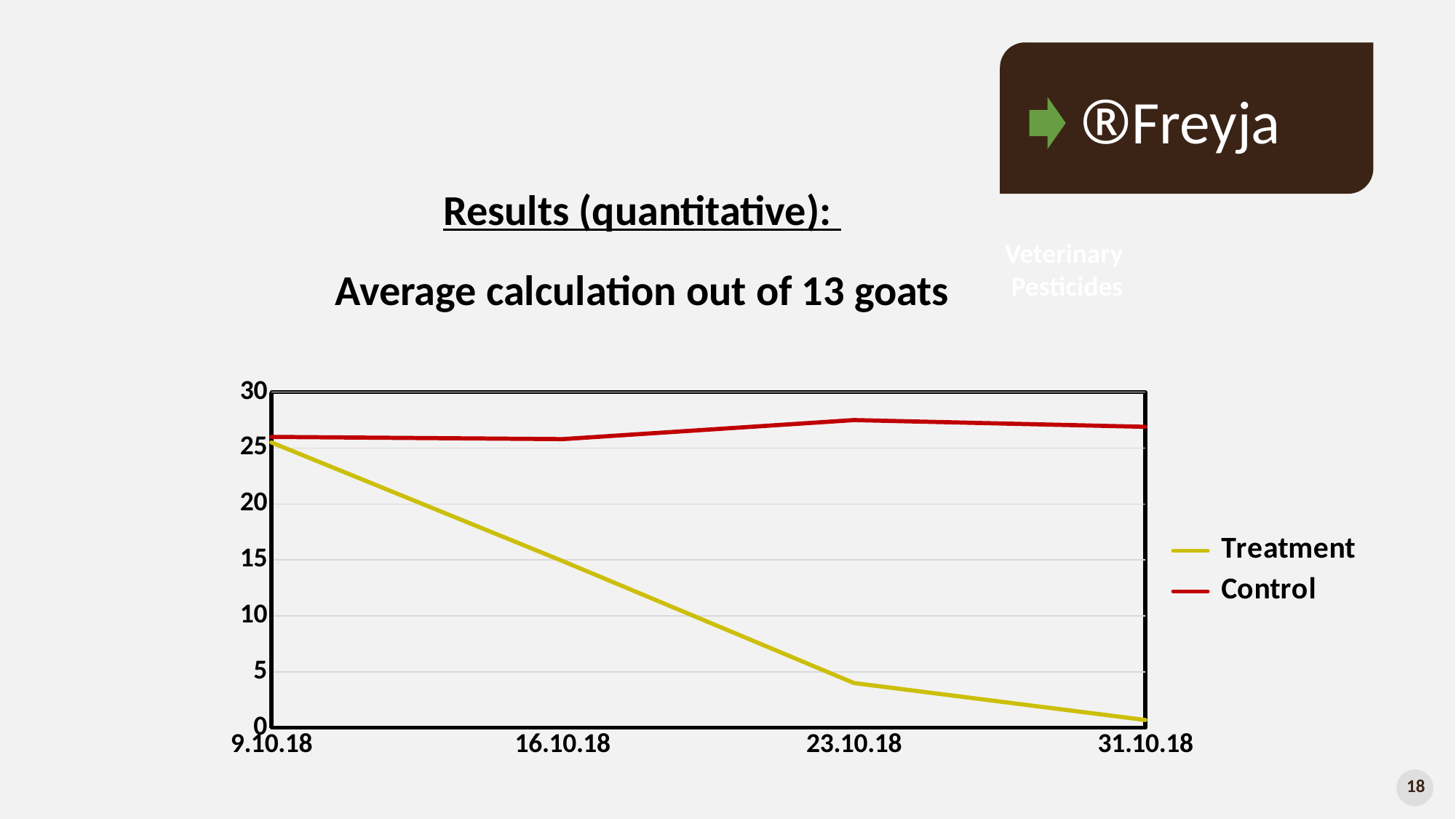
On 31.10.18, which series has the higher value, Treatment or Control? Control Is the Control value on 23.10.18 greater or less than 25? greater How many dates are shown on the x axis? 4 Which series are listed in the legend? Treatment, Control How many series does the legend list? 2 What colour is the Control line? red Is the Treatment value on 23.10.18 greater or less than 5? less On which date is the Treatment value lowest? 31.10.18 Does the Treatment line rise or fall from 9.10.18 to 31.10.18? fall Is the Treatment value on 16.10.18 greater or less than 20? less What kind of chart is shown on the slide? line chart